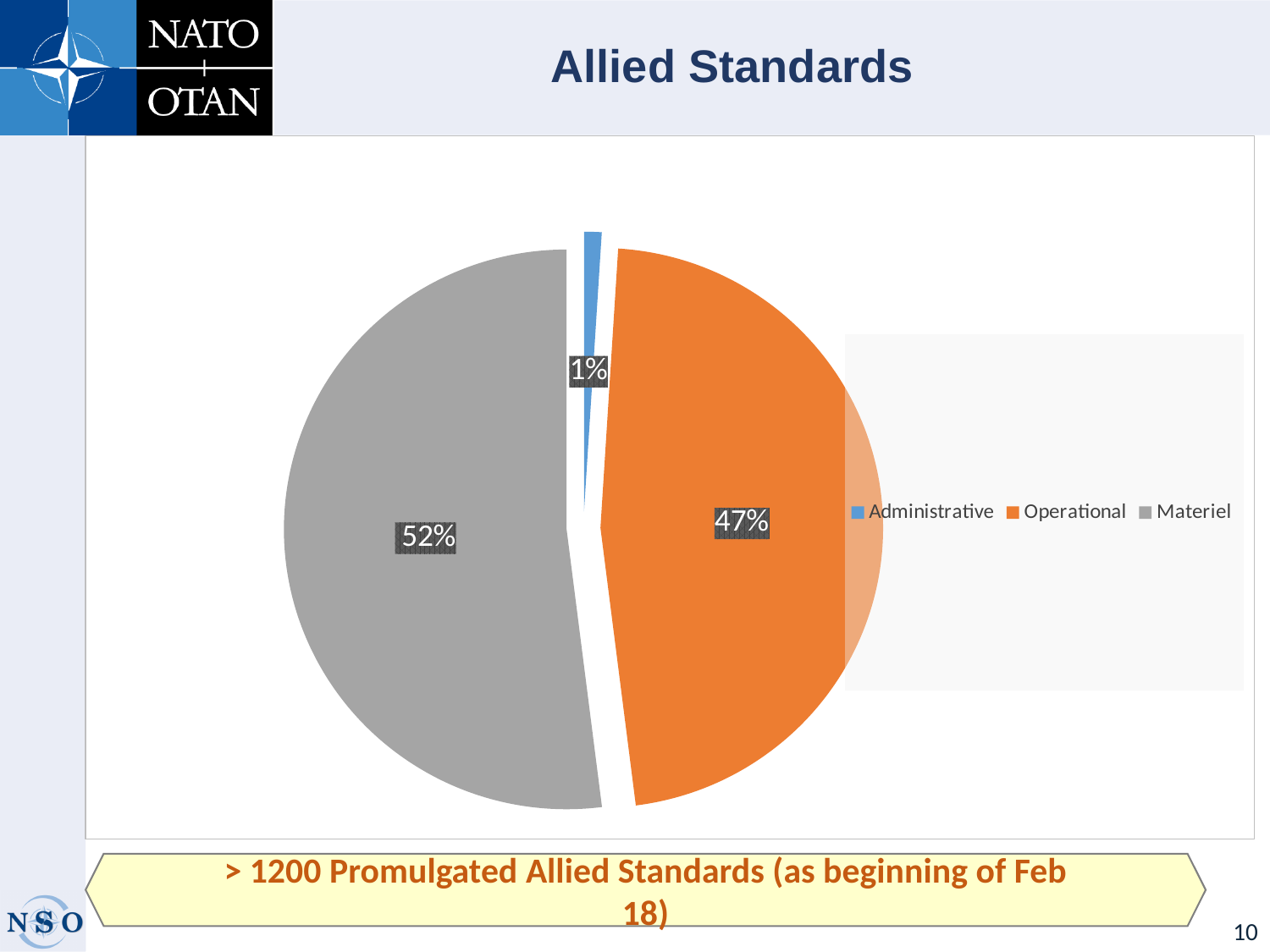
What kind of chart is shown on the slide? Pie chart What is the difference in percentage points between the Materiel and Operational shares? 5 What is the difference in percentage points between the Operational and Administrative shares? 46 What share of the pie chart is Administrative? 1% What is the title of the slide containing the pie chart? Allied Standards What share of the pie chart is Operational? 47% How many categories does the pie chart show? 3 Which is larger, the Materiel share or the Operational share? Materiel Which colour represents Operational in the pie chart? Orange Which category has the largest share of the pie chart? Materiel What share of the pie chart is Materiel? 52% Which category has the smallest share of the pie chart? Administrative